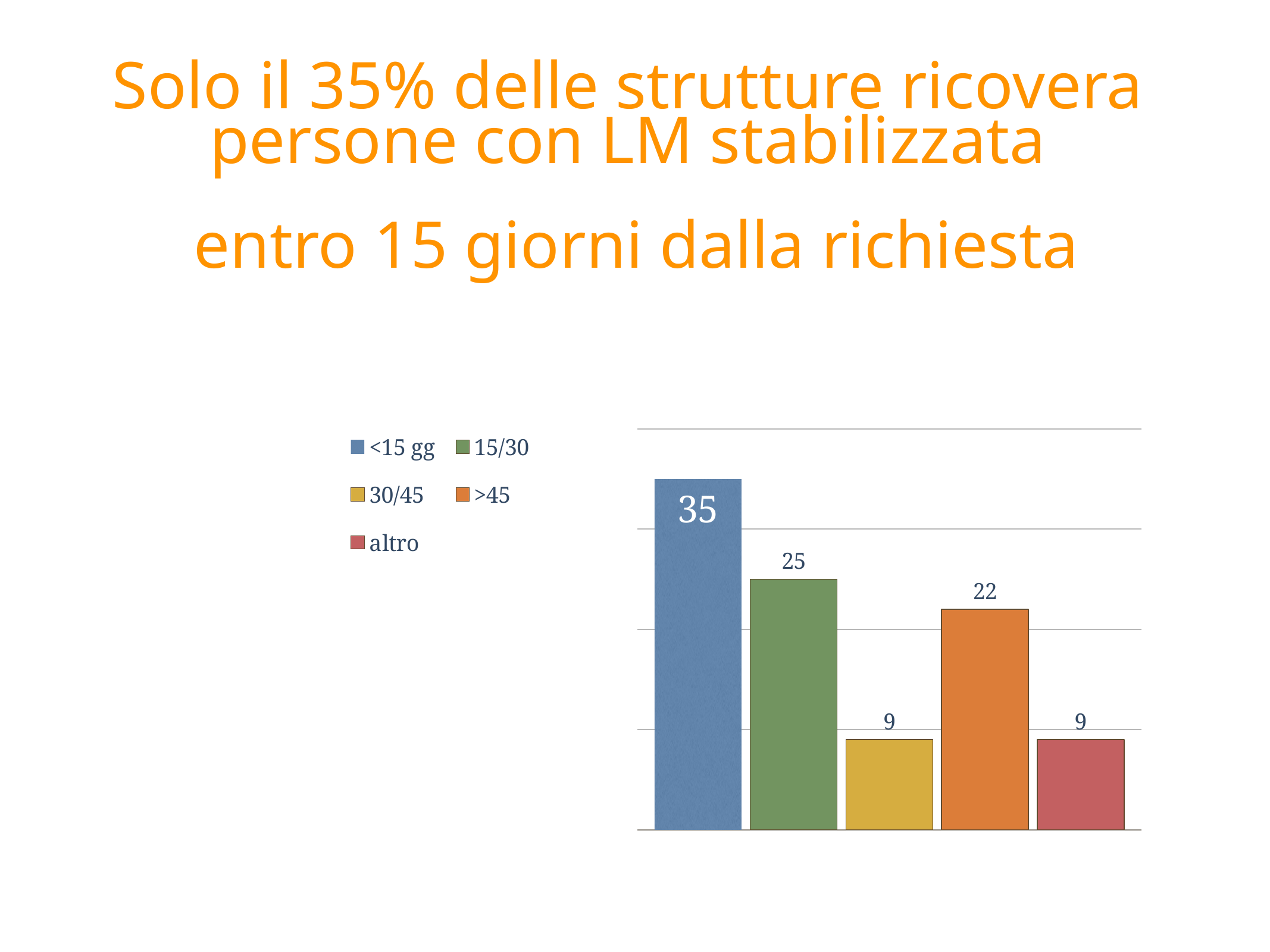
What is the value for >45? 22 What is the value for 15/30? 25 What is the difference between the values for >45 and 30/45? 13 Which is larger, the value for 15/30 or the value for >45? 15/30 How many entries does the legend list? 5 What is the difference between the values for <15 gg and 15/30? 10 What is the value for <15 gg? 35 Which category has the highest value? <15 gg What is the value for 30/45? 9 What kind of chart is shown on the slide? bar chart What is the value for altro? 9 How many bars are plotted in the chart? 5